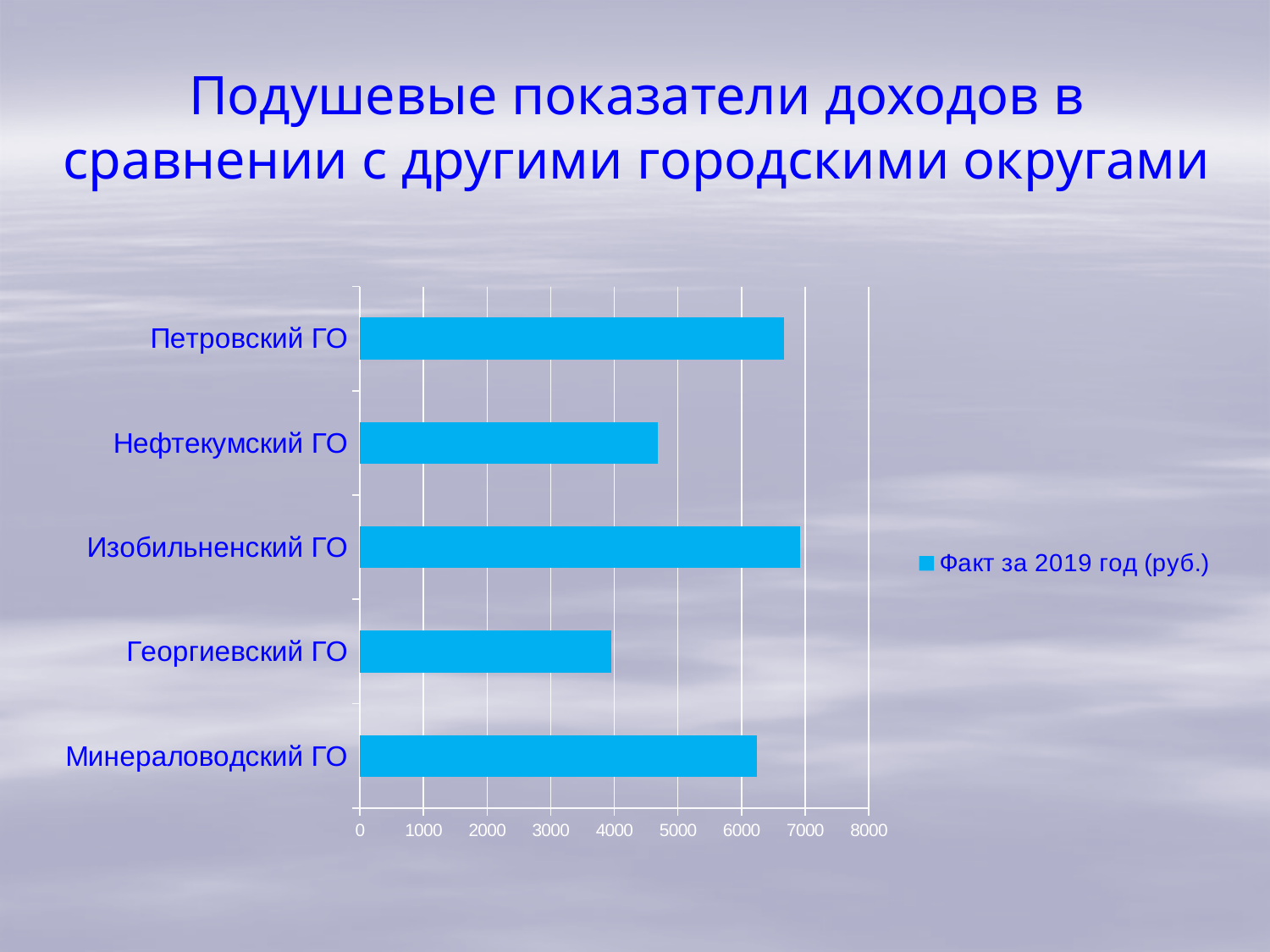
Which has the larger value, Петровский ГО or Нефтекумский ГО? Петровский ГО Is the value for Георгиевский ГО greater or less than 5000? less Which city district has the lowest value in the chart? Георгиевский ГО How many city districts (categories) are shown in the chart? 5 What kind of chart is shown on the slide? Bar chart Which has the larger value, Минераловодский ГО or Георгиевский ГО? Минераловодский ГО Which city district has the highest value in the chart? Изобильненский ГО Is the value for Нефтекумский ГО greater or less than 5000? less Is the value for Минераловодский ГО greater or less than 6000? greater What is the legend entry for the series in the chart? Факт за 2019 год (руб.) How many series does the legend list? 1